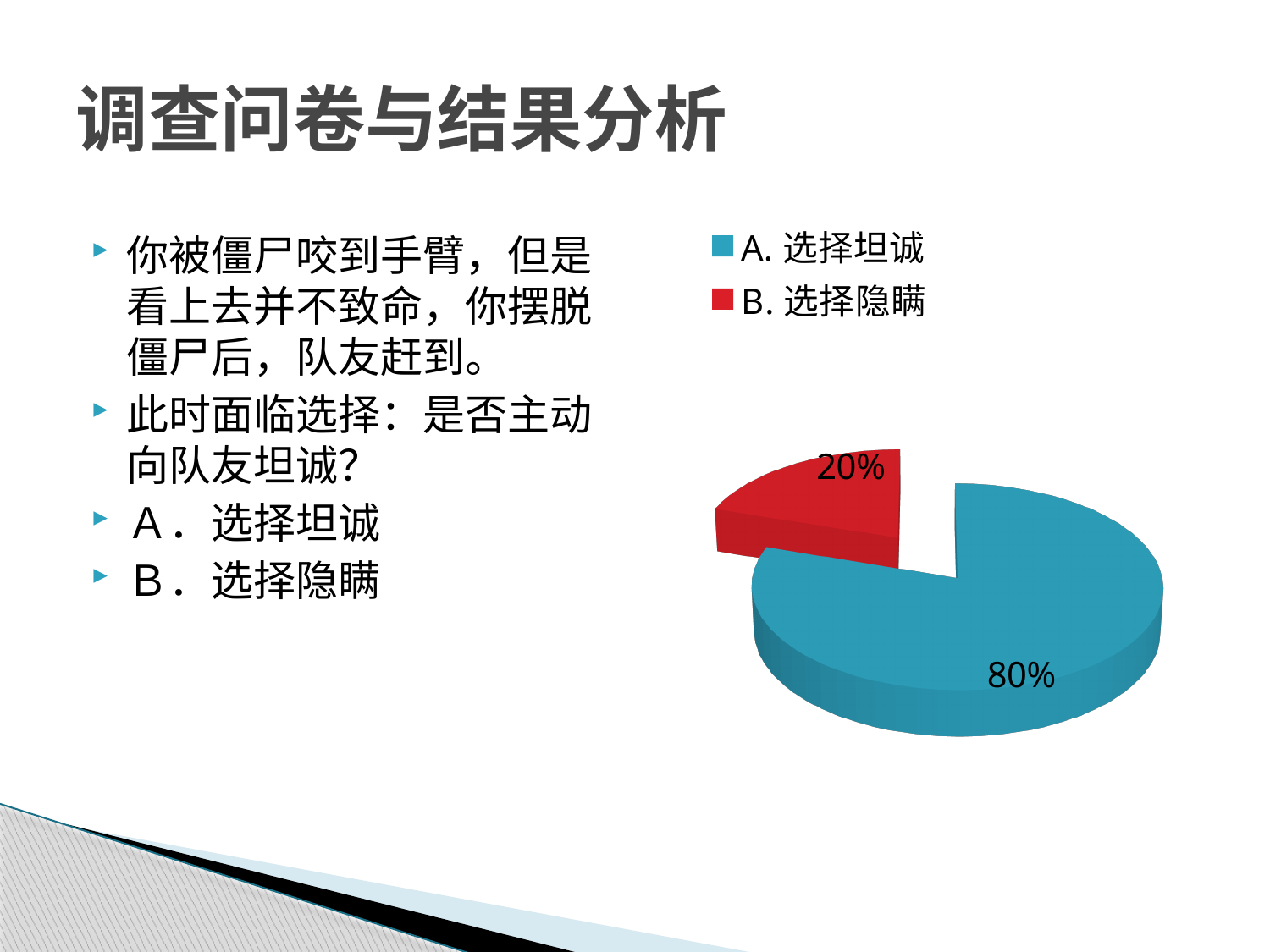
What colour is the slice for B. 选择隐瞒? red How many slices does the pie chart have? 2 What kind of chart is shown on the slide? pie chart Which slice of the pie is the smallest? B. 选择隐瞒 What share of the pie does A. 选择坦诚 take? 80% How many entries does the legend list? 2 What share of the pie does B. 选择隐瞒 take? 20% Which is larger, the share for A. 选择坦诚 or the share for B. 选择隐瞒? A. 选择坦诚 Which slice of the pie is the largest? A. 选择坦诚 What colour is the slice for A. 选择坦诚? blue What is the difference in percentage points between A. 选择坦诚 and B. 选择隐瞒? 60%